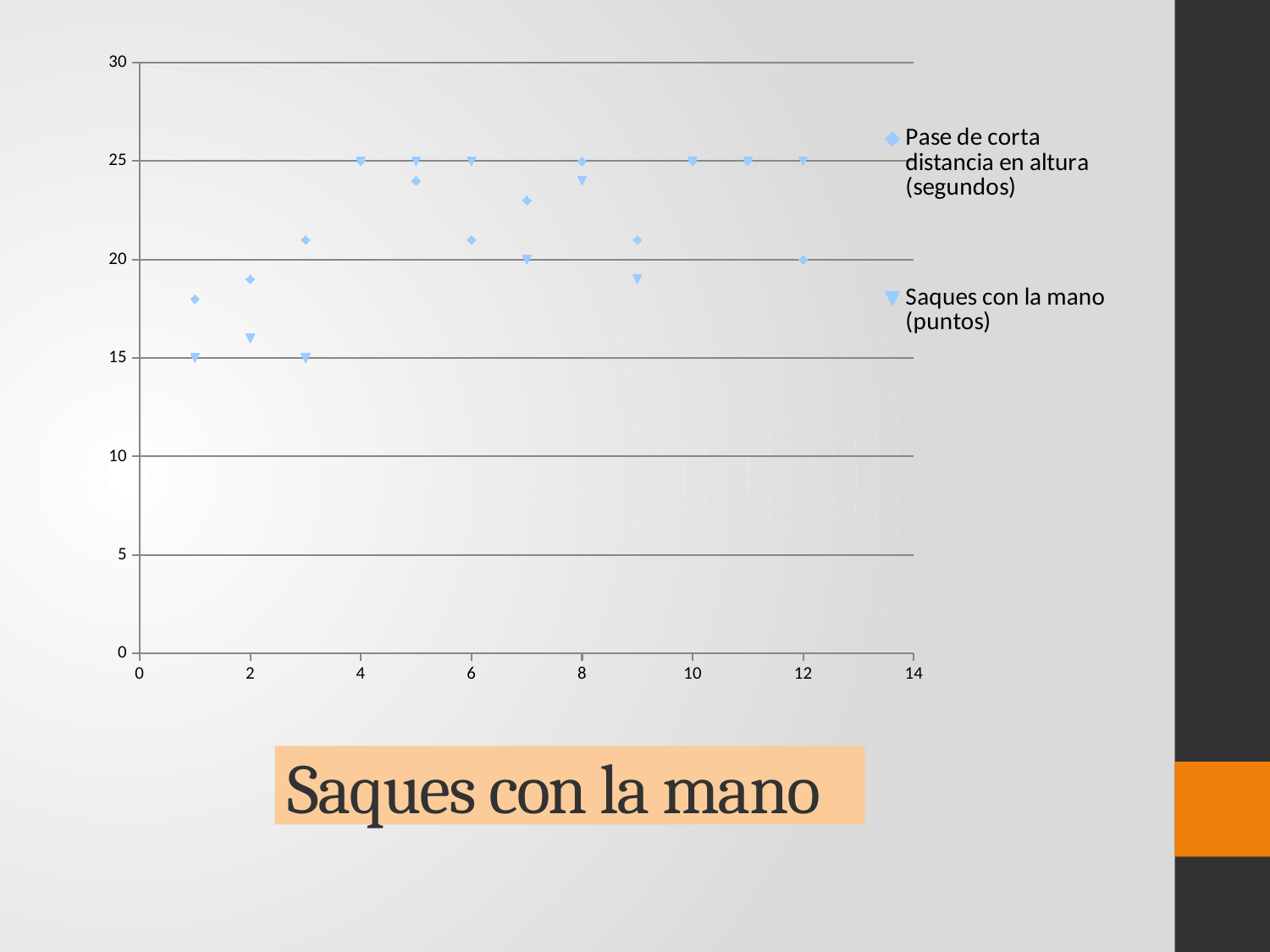
Do the values of 'Saques con la mano (puntos)' generally rise or fall from x = 1 to x = 12? rise What is the value of 'Saques con la mano (puntos)' at x = 1? 15 At x = 3, which series has the larger value, 'Pase de corta distancia en altura (segundos)' or 'Saques con la mano (puntos)'? Pase de corta distancia en altura (segundos) Is the value for 'Pase de corta distancia en altura (segundos)' at x = 1 greater or less than 20? less Is the value for 'Saques con la mano (puntos)' at x = 9 greater or less than 15? greater What is the value of 'Saques con la mano (puntos)' at x = 7? 20 What kind of chart is shown on the slide? scatter chart What is the value of 'Pase de corta distancia en altura (segundos)' at x = 4? 25 How many data points are plotted for the 'Saques con la mano (puntos)' series? 12 What is the value of 'Pase de corta distancia en altura (segundos)' at x = 12? 20 What is the title shown below the chart? Saques con la mano How many series does the legend list? 2